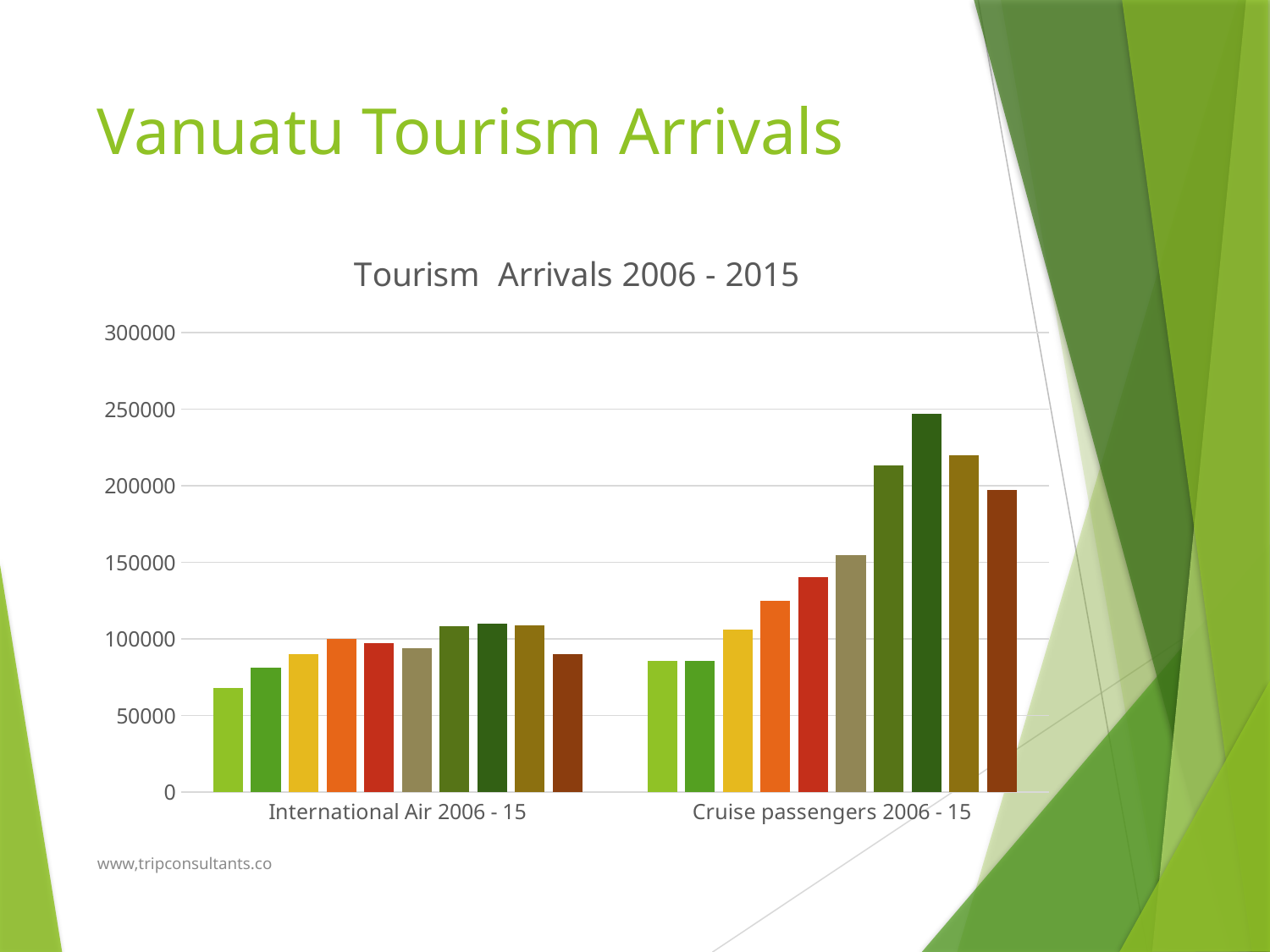
How many category groups are shown on the x axis of the chart? 2 Is the first (leftmost) bar in the International Air 2006 - 15 group greater or less than 100000? less What kind of chart is shown on the slide? bar chart How many bars are in the International Air 2006 - 15 group? 10 Is the tallest bar in the Cruise passengers 2006 - 15 group greater or less than 200000? greater Is the first (leftmost) bar in the Cruise passengers 2006 - 15 group greater or less than 100000? less Which is larger: the tallest bar for Cruise passengers 2006 - 15 or the tallest bar for International Air 2006 - 15? Cruise passengers 2006 - 15 Which category group contains the shortest bar in the chart? International Air 2006 - 15 How many bars are in the Cruise passengers 2006 - 15 group? 10 Do the bars in the Cruise passengers 2006 - 15 group generally rise or fall from left to right? rise Which category group contains the tallest bar in the chart? Cruise passengers 2006 - 15 What is the title of the chart? Tourism Arrivals 2006 - 2015